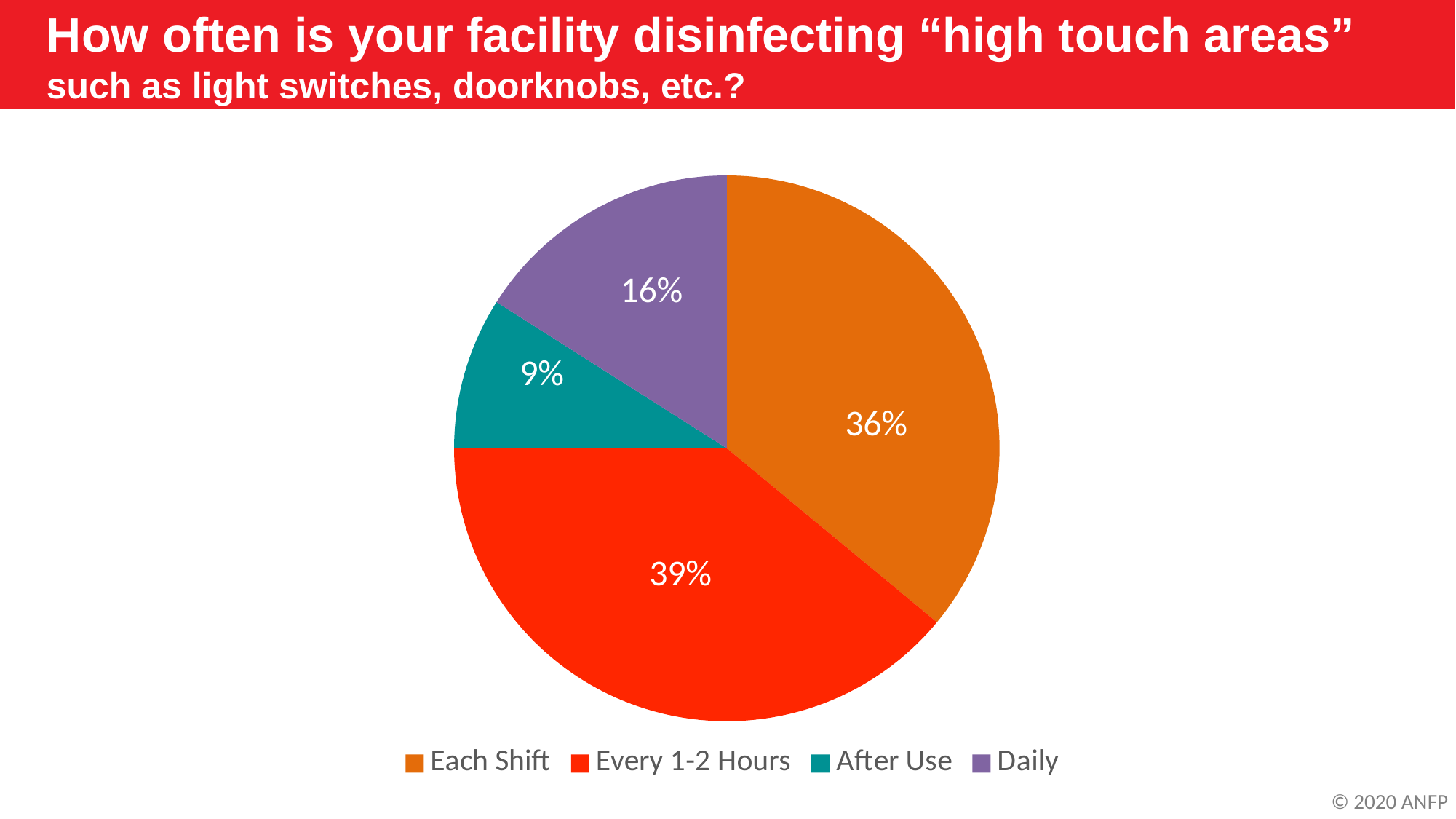
What percentage of facilities disinfect high touch areas Daily? 16% What percentage of facilities disinfect high touch areas After Use? 9% What type of chart is shown on the slide? pie chart What colour is the slice for After Use? teal What is the difference in percentage points between Every 1-2 Hours and Each Shift? 3 Which is larger, the share for Daily or the share for After Use? Daily What percentage of facilities disinfect high touch areas Each Shift? 36% What is the difference in percentage points between Daily and After Use? 7 How many categories does the pie chart show? 4 What percentage of facilities disinfect high touch areas Every 1-2 Hours? 39% Which response has the smallest share of the pie? After Use Which response has the largest share of the pie? Every 1-2 Hours